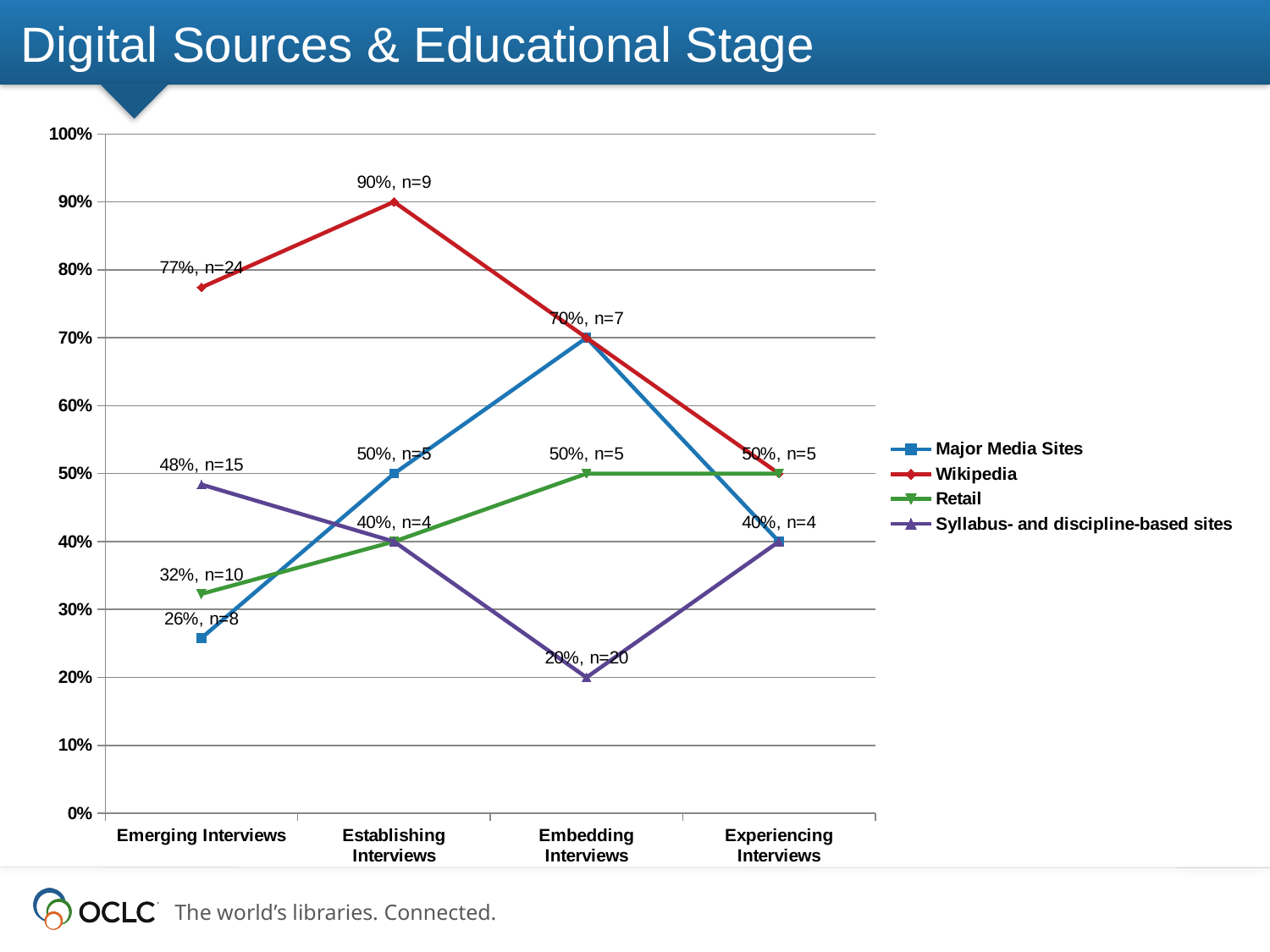
How many series does the legend list? 4 What is the n value shown for Wikipedia at Emerging Interviews? n=24 What kind of chart is shown on the slide? line chart At Emerging Interviews, which is larger: Syllabus- and discipline-based sites or Retail? Syllabus- and discipline-based sites What colour is the Wikipedia line? red What is the value for Wikipedia at Establishing Interviews? 90% What is the difference between Wikipedia and Major Media Sites at Emerging Interviews? 51 percentage points How many educational stages are shown along the x axis? 4 At which stage does Wikipedia reach its highest value? Establishing Interviews Does the Wikipedia line rise or fall from Establishing Interviews to Experiencing Interviews? fall At which stage do Syllabus- and discipline-based sites have their lowest value? Embedding Interviews What is the value for Major Media Sites at Emerging Interviews? 26%